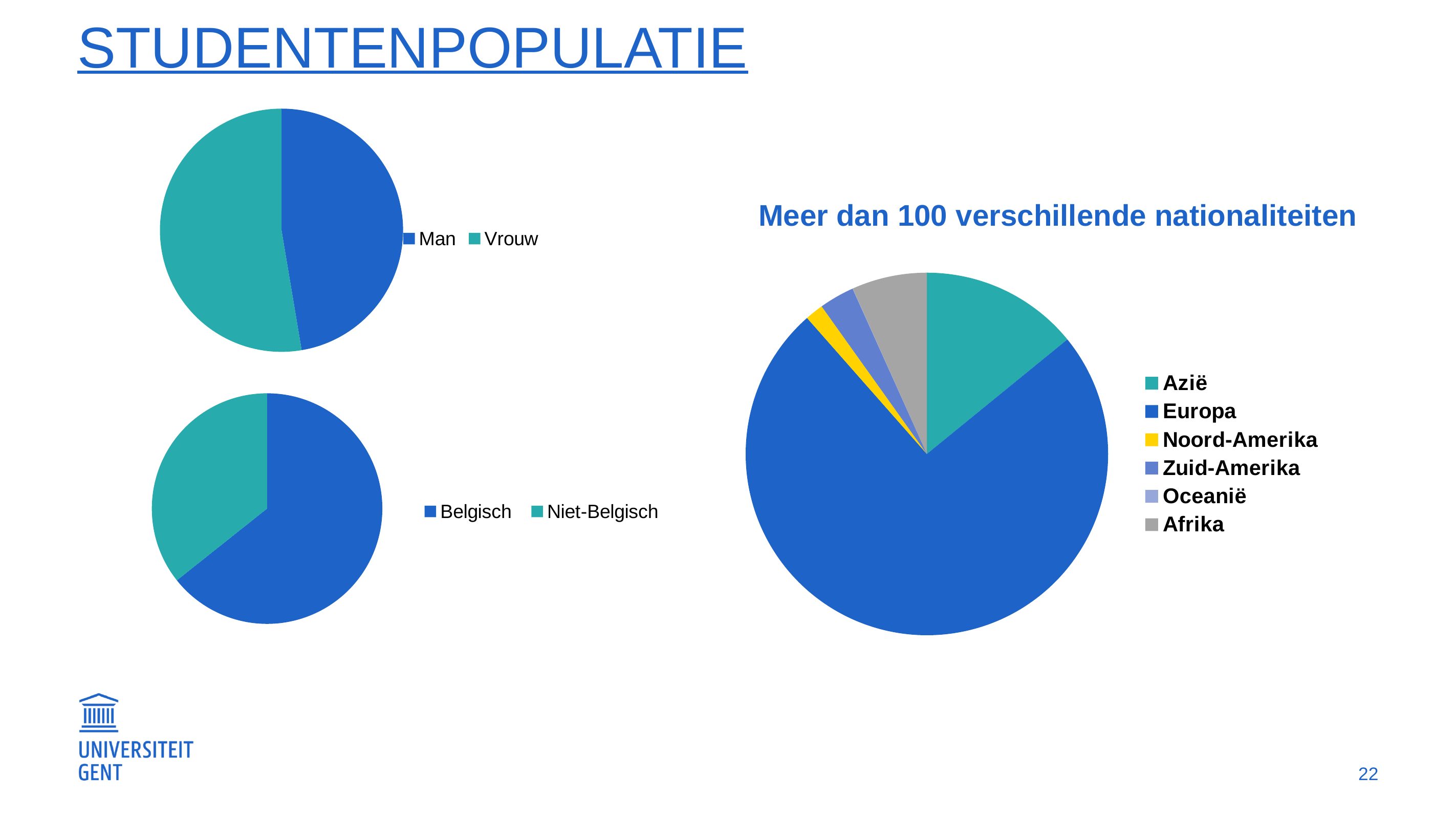
In the chart on the right titled 'Meer dan 100 verschillende nationaliteiten', which category has the largest slice? Europa In the chart on the right titled 'Meer dan 100 verschillende nationaliteiten', how many categories does the legend list? 6 How many categories does the legend of the top-left pie chart list? 2 In the bottom-left pie chart, which category has the largest slice? Belgisch What kind of chart is the chart on the right titled 'Meer dan 100 verschillende nationaliteiten'? pie chart In the chart on the right titled 'Meer dan 100 verschillende nationaliteiten', which slice is larger, Azië or Afrika? Azië In the bottom-left pie chart, which slice is larger, Belgisch or Niet-Belgisch? Belgisch In the chart on the right titled 'Meer dan 100 verschillende nationaliteiten', which slice is larger, Afrika or Noord-Amerika? Afrika In the chart on the right titled 'Meer dan 100 verschillende nationaliteiten', what colour is the Noord-Amerika slice? yellow What is the title of the chart on the right? Meer dan 100 verschillende nationaliteiten What kind of chart is the top-left chart with the legend 'Man' and 'Vrouw'? pie chart